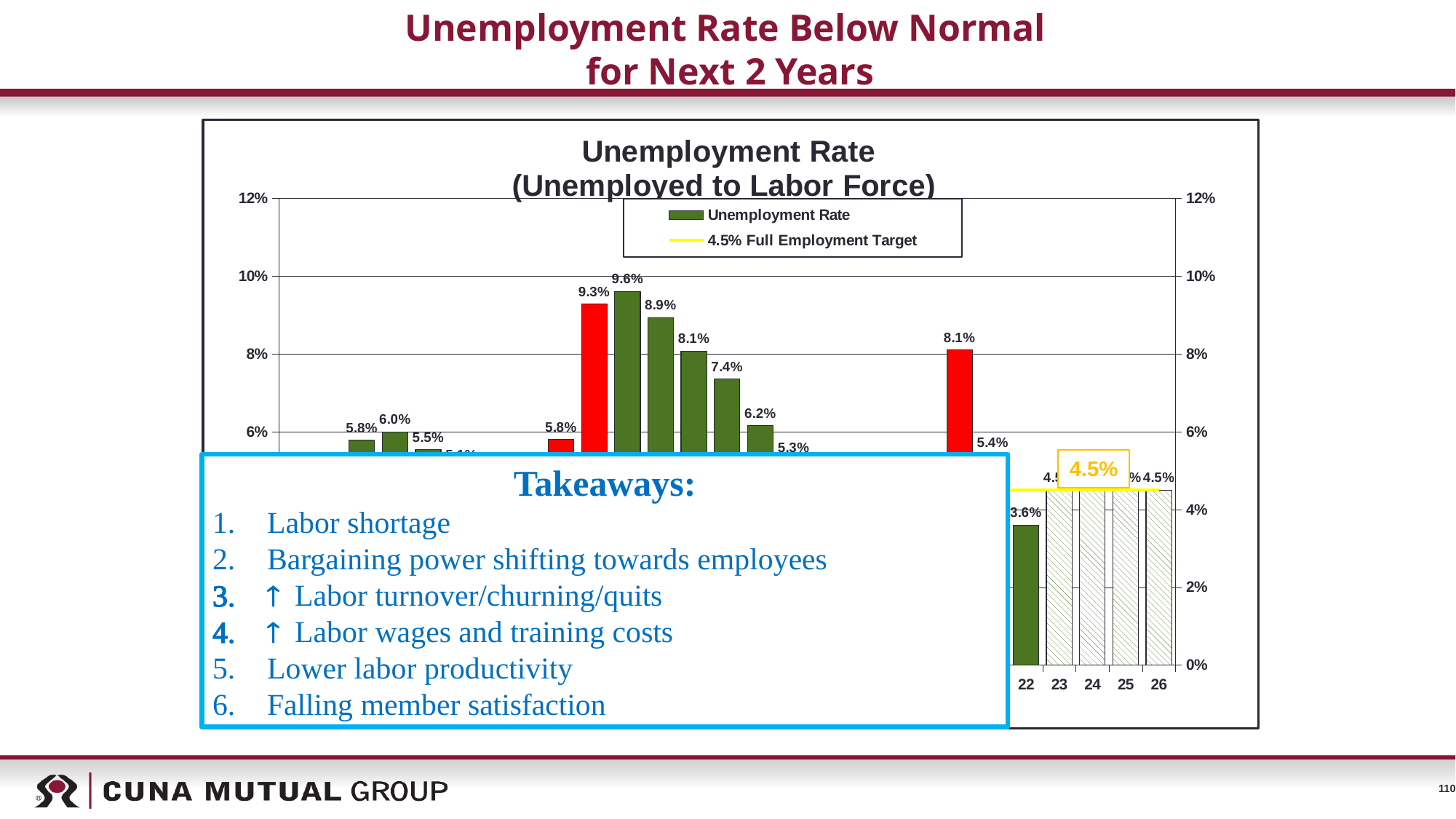
What is the difference between the unemployment rate for 26 and for 22? 0.9 percentage points What is the highest unemployment rate labeled on the chart? 9.6% What is the maximum value shown on the chart's vertical axis? 12% Is the unemployment rate for 22 greater or less than 4%? less What is the lowest unemployment rate labeled on the chart? 3.6% What is the title of the chart? Unemployment Rate (Unemployed to Labor Force) What are the two entries in the chart legend? Unemployment Rate; 4.5% Full Employment Target What kind of chart is shown on the slide? bar chart How many series does the chart legend list? 2 Which has the higher unemployment rate, 22 or 26? 26 What is the unemployment rate shown for 26? 4.5% What is the unemployment rate shown for 22? 3.6%